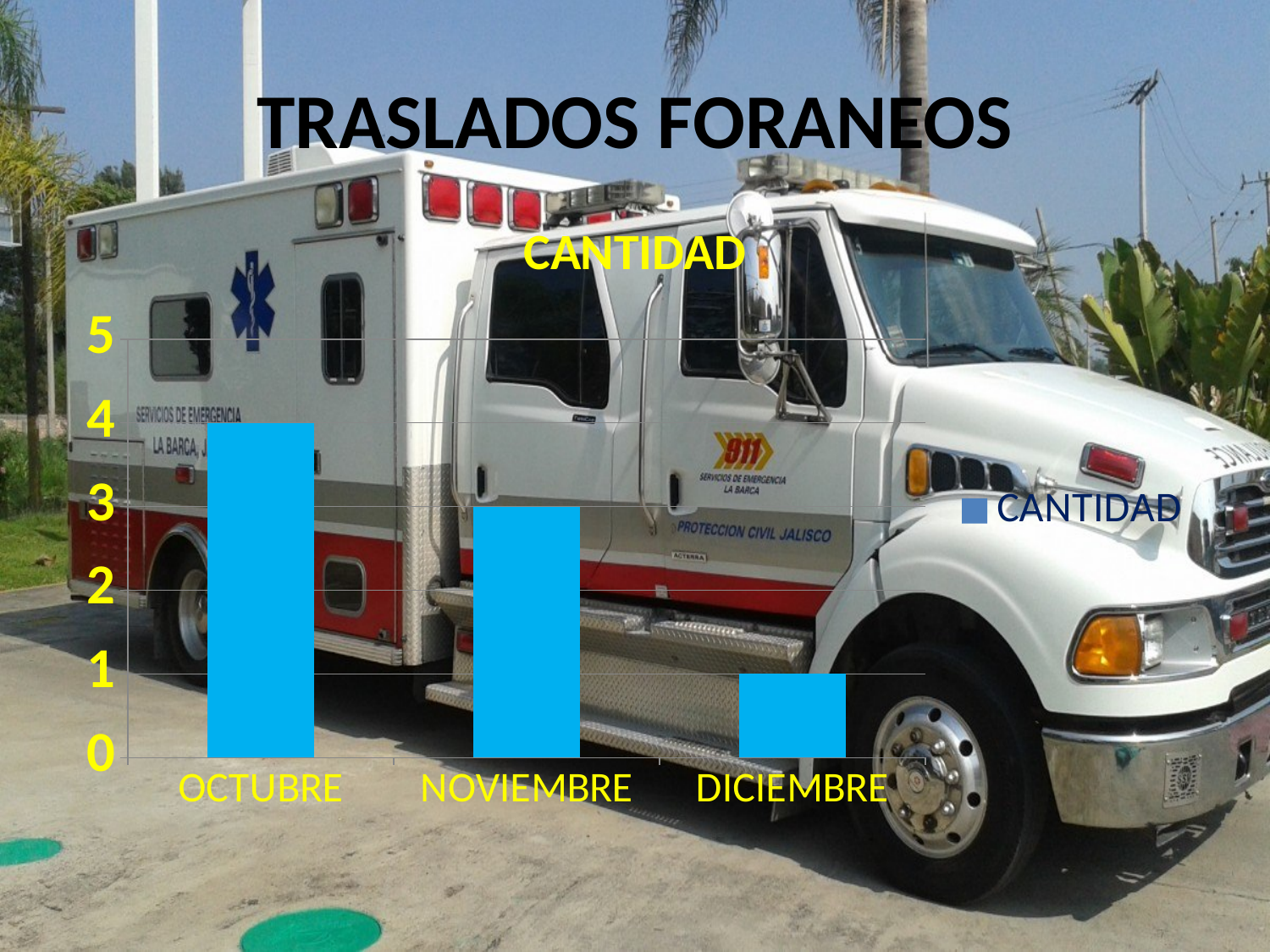
What is the difference between the values for OCTUBRE and DICIEMBRE? 3 What is the value for OCTUBRE? 4 Which is larger, the value for NOVIEMBRE or the value for DICIEMBRE? NOVIEMBRE What is the title of the chart? CANTIDAD What type of chart is shown on the slide? bar chart What is the value for DICIEMBRE? 1 Which month has the highest value? OCTUBRE How many categories are shown on the x axis of the chart? 3 What is the value for NOVIEMBRE? 3 Do the values rise or fall from OCTUBRE to DICIEMBRE? fall Which month has the lowest value? DICIEMBRE How many series does the chart legend list? 1